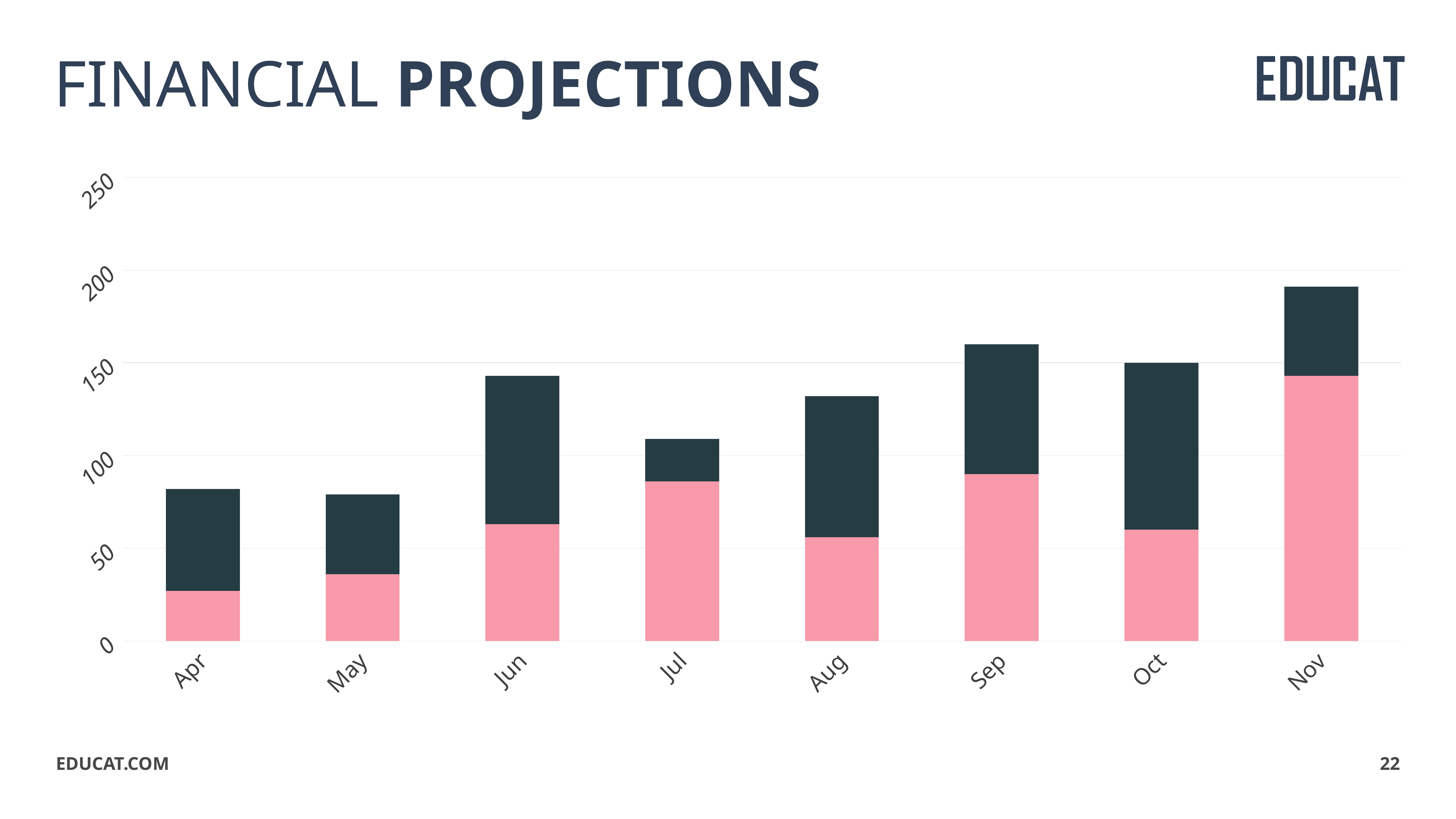
Which month has the larger total stacked bar, Jun or Jul? Jun What is the title of the slide containing the chart? FINANCIAL PROJECTIONS Which month has the tallest stacked bar? Nov Do the total stacked values generally rise or fall from Apr to Nov? rise Is the total stacked value for Sep greater or less than 150? greater Is the pink (bottom) segment for Apr greater or less than 50? less What kind of chart is shown on the slide? Stacked bar chart How many months are shown on the x axis of the chart? 8 Is the total stacked value for Apr greater or less than 100? less